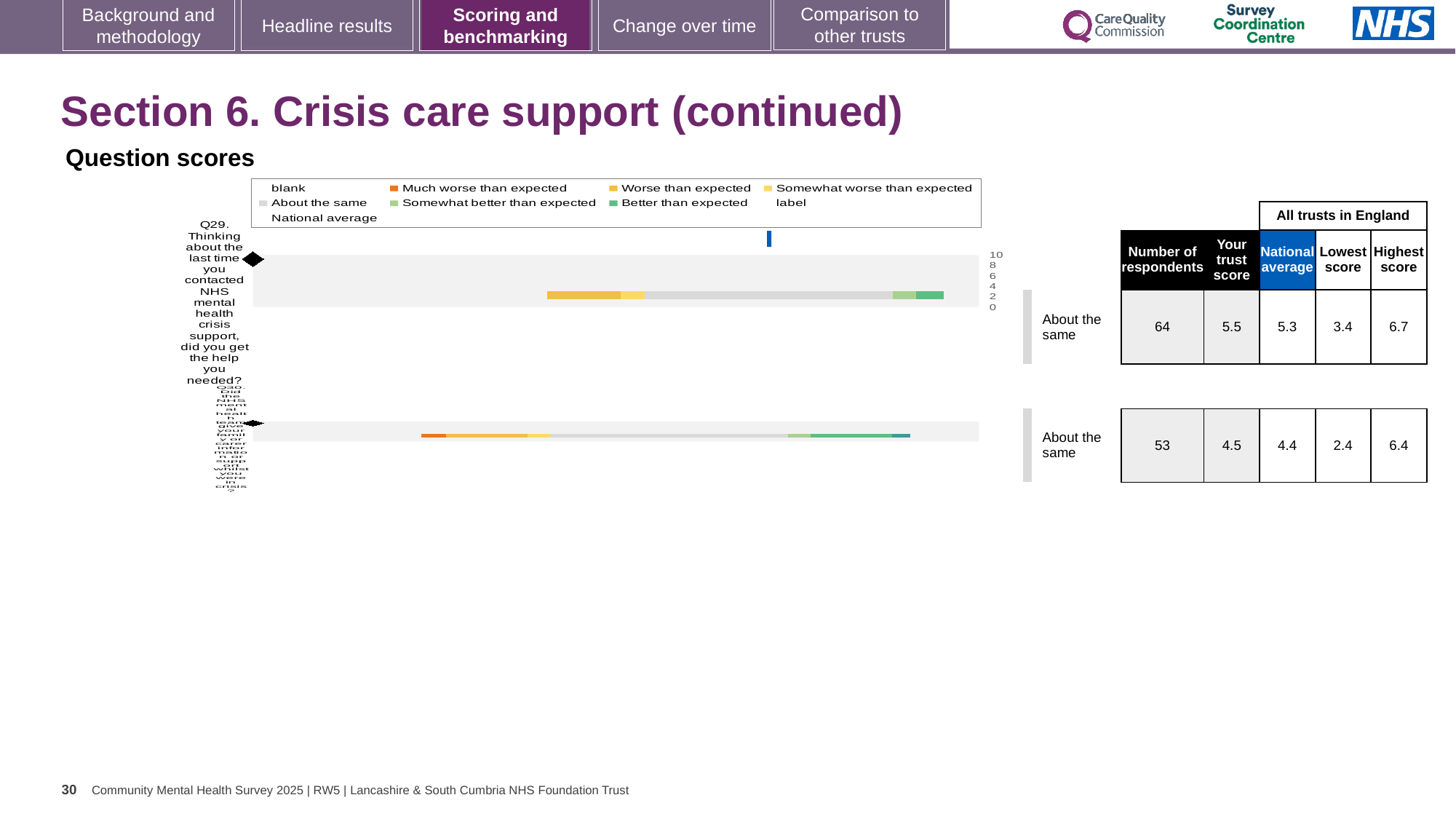
What kind of chart is used to show the question scores on this slide? bar chart What is the heading above the chart on this slide? Question scores What benchmark category is shown for Q29 next to the chart? About the same What is the lowest score across all trusts in England shown for Q30? 2.4 How many questions are plotted in the Question scores chart? 2 How many entries does the legend of the Question scores chart list? 9 What is the difference between the highest score and the lowest score shown for Q29? 3.3 How many respondents are shown for Q29? 64 Which question has the higher trust score, Q29 or Q30? Q29 What is the national average shown for Q30? 4.4 What colour represents 'Much worse than expected' in the chart legend? orange What is the trust score shown for Q29 in the table beside the chart? 5.5